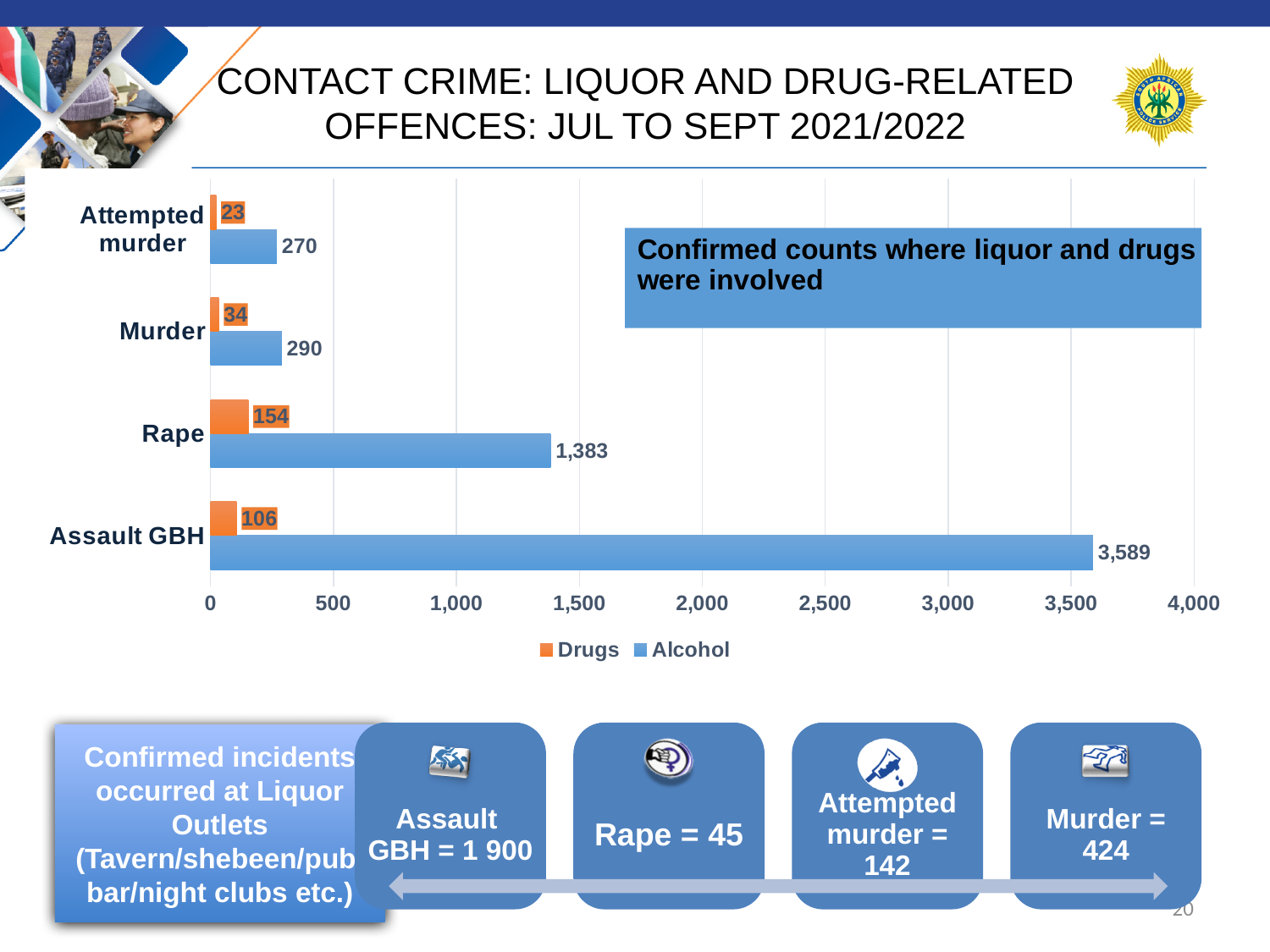
Is the Alcohol value for Rape greater or less than 1,500? less How many series does the legend list? 2 What kind of chart is shown on the slide? bar chart What is the Alcohol value for Attempted murder? 270 What is the Drugs value for Murder? 34 What is the difference between the Alcohol and Drugs values for Rape? 1,229 What is the Alcohol value for Assault GBH? 3,589 Which category has the lowest Drugs value? Attempted murder Which is larger, the Drugs value for Rape or the Drugs value for Assault GBH? Rape How many crime categories are shown on the chart? 4 Which category has the highest Alcohol value? Assault GBH What is the Drugs value for Rape? 154